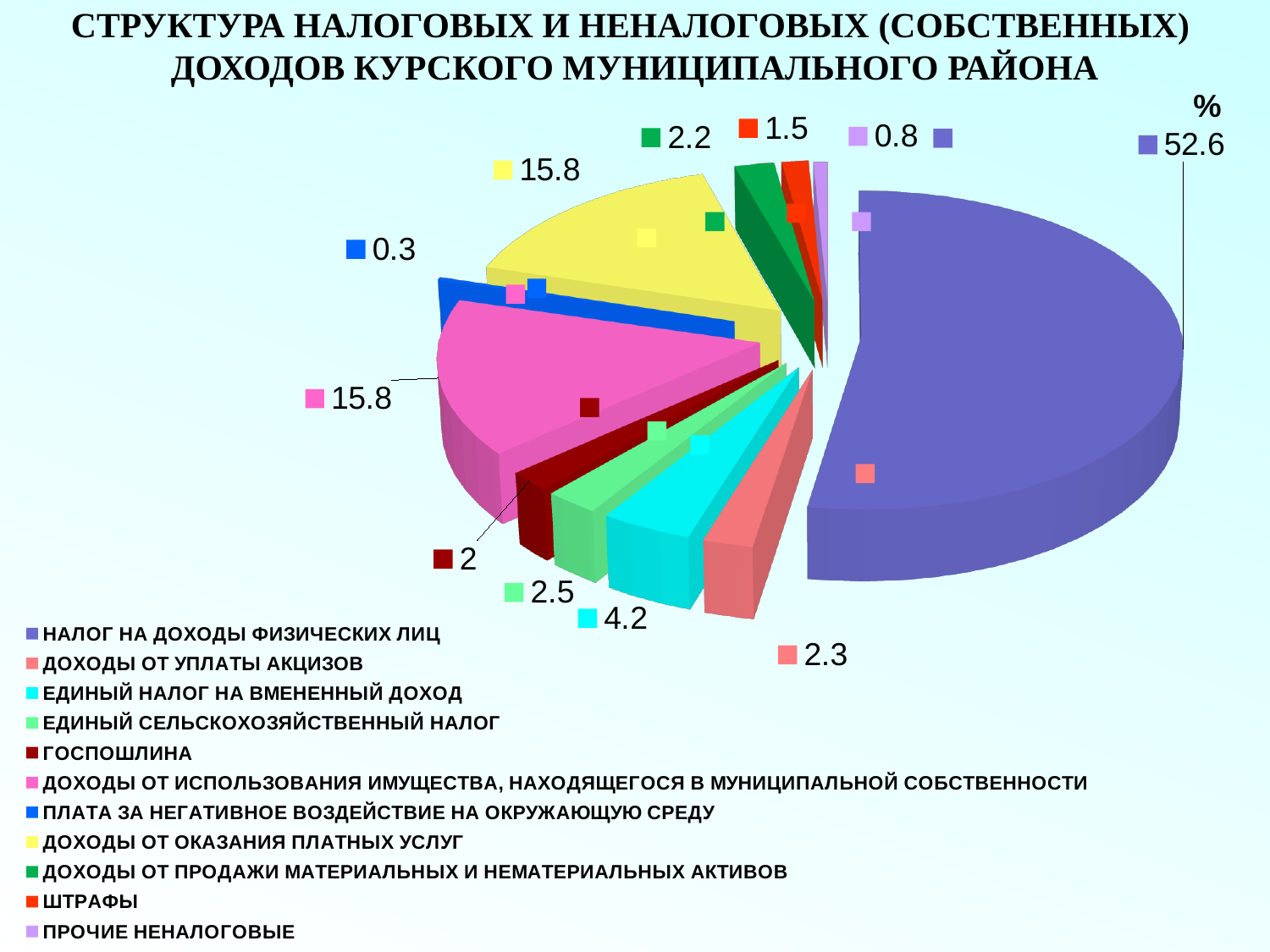
What is the difference between the values for ЕДИНЫЙ НАЛОГ НА ВМЕНЕННЫЙ ДОХОД and ЕДИНЫЙ СЕЛЬСКОХОЗЯЙСТВЕННЫЙ НАЛОГ? 1.7 What kind of chart is shown on the slide? pie chart How many categories does the legend list? 11 Which category has the largest share of the pie? НАЛОГ НА ДОХОДЫ ФИЗИЧЕСКИХ ЛИЦ What is the value for ДОХОДЫ ОТ ОКАЗАНИЯ ПЛАТНЫХ УСЛУГ? 15.8 What colour is the slice for ДОХОДЫ ОТ ИСПОЛЬЗОВАНИЯ ИМУЩЕСТВА, НАХОДЯЩЕГОСЯ В МУНИЦИПАЛЬНОЙ СОБСТВЕННОСТИ? pink What is the value for ЕДИНЫЙ НАЛОГ НА ВМЕНЕННЫЙ ДОХОД? 4.2 What is the value for ШТРАФЫ? 1.5 Which category has the smallest share of the pie? ПЛАТА ЗА НЕГАТИВНОЕ ВОЗДЕЙСТВИЕ НА ОКРУЖАЮЩУЮ СРЕДУ Which is larger, the value for ДОХОДЫ ОТ УПЛАТЫ АКЦИЗОВ or the value for ГОСПОШЛИНА? ДОХОДЫ ОТ УПЛАТЫ АКЦИЗОВ What is the value for ПЛАТА ЗА НЕГАТИВНОЕ ВОЗДЕЙСТВИЕ НА ОКРУЖАЮЩУЮ СРЕДУ? 0.3 What is the value for НАЛОГ НА ДОХОДЫ ФИЗИЧЕСКИХ ЛИЦ? 52.6